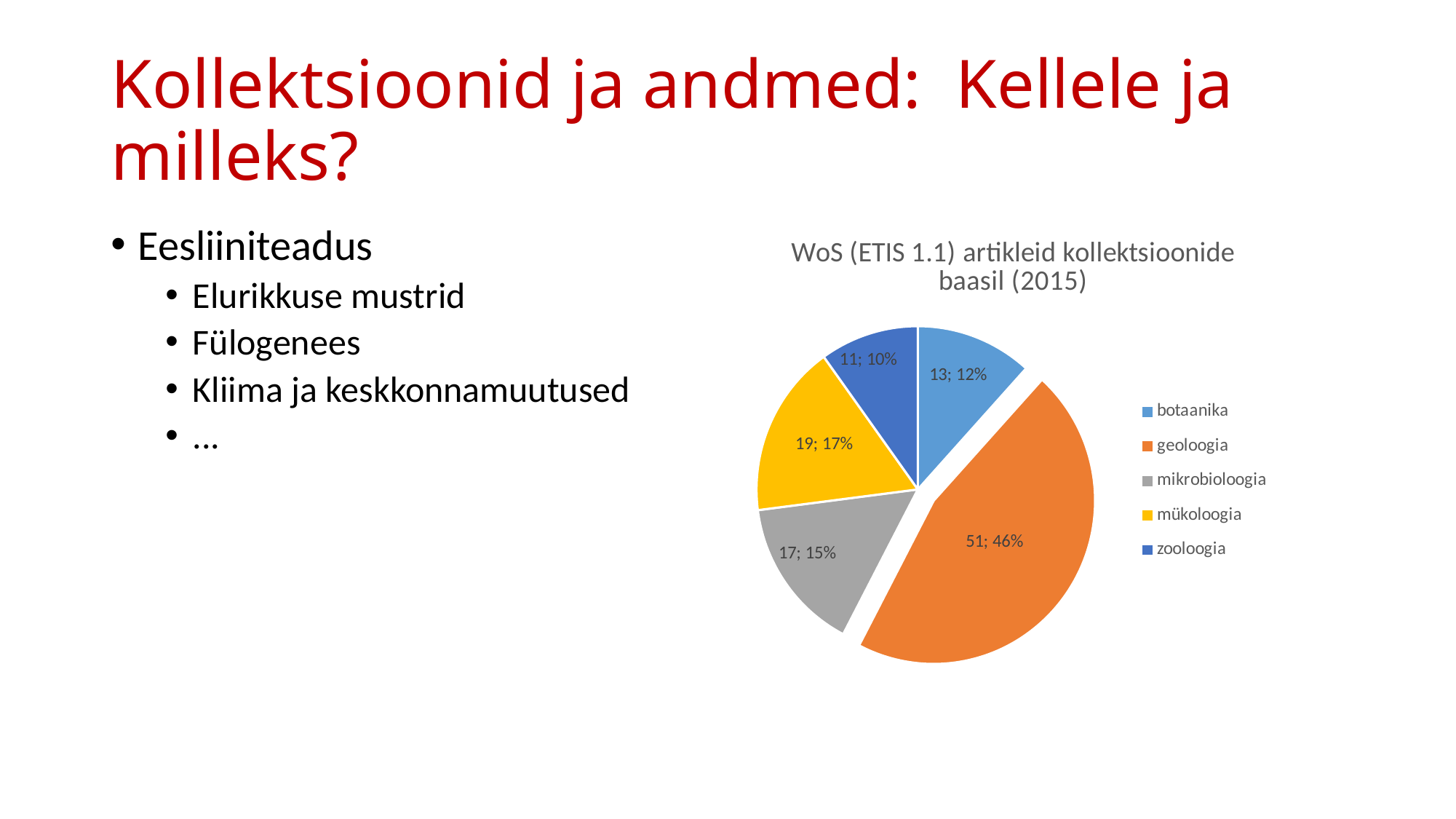
How many articles does the geoloogia slice represent? 51 Which category has the largest slice? geoloogia What percentage share does the zooloogia slice have? 10% What kind of chart is shown on the slide? pie chart How many slices does the pie chart have? 5 What is the difference between the values for geoloogia and mikrobioloogia? 34 Which colour represents mikrobioloogia in the legend? grey Which is larger, the value for mükoloogia or the value for botaanika? mükoloogia Which category has the smallest slice? zooloogia What percentage share does the mükoloogia slice have? 17% What is the value shown for botaanika? 13 What is the title of the chart? WoS (ETIS 1.1) artikleid kollektsioonide baasil (2015)